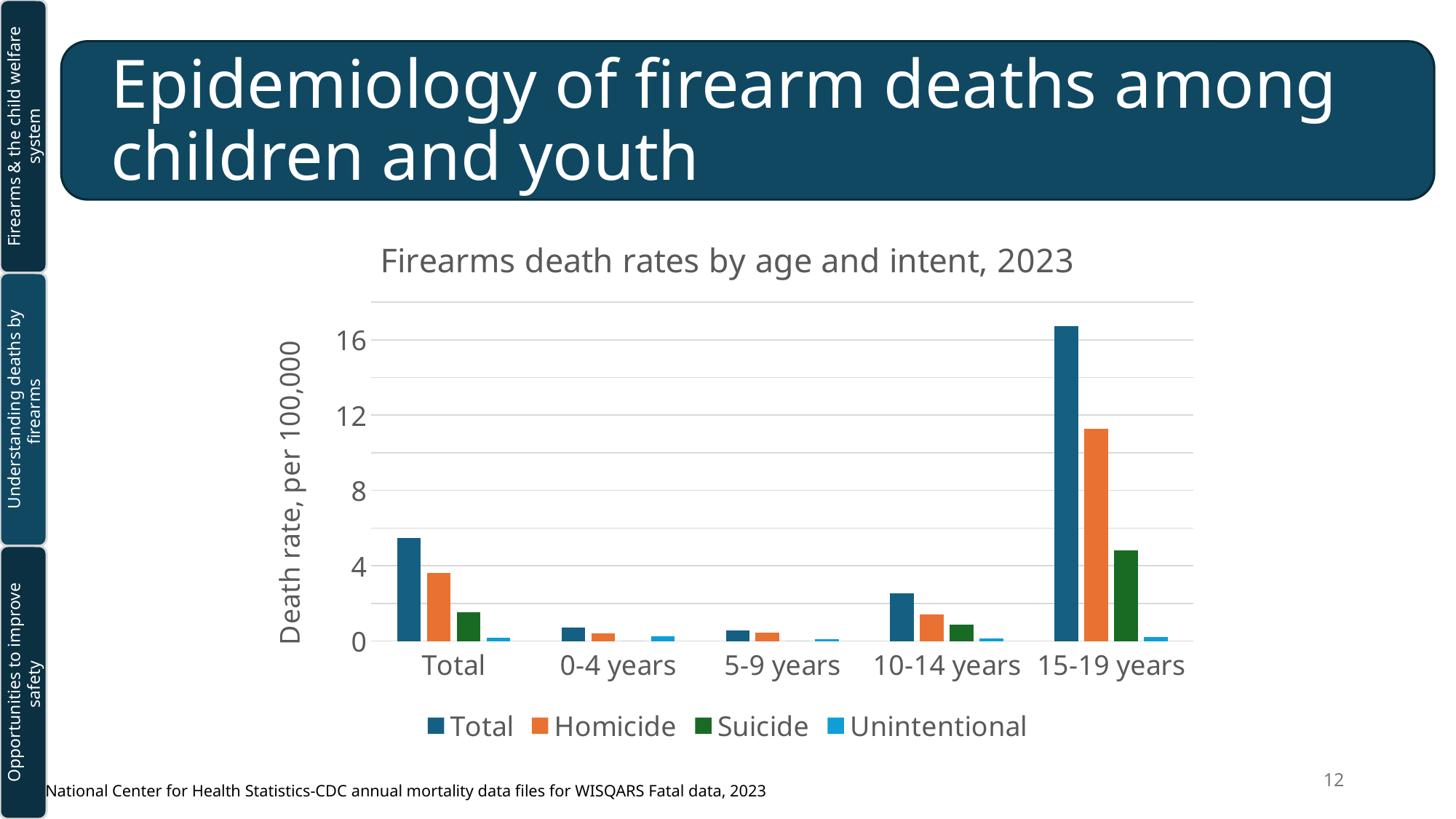
What is the title of the chart? Firearms death rates by age and intent, 2023 How many series does the legend list? 4 Which is larger for the 15-19 years group, the Homicide rate or the Suicide rate? Homicide Is the Homicide death rate for 15-19 years greater or less than 12? less Which series has the lowest death rate in the 15-19 years group? Unintentional Which age group has the highest Total firearm death rate? 15-19 years Is the Suicide death rate for 15-19 years greater or less than 4? greater What is the label of the y axis? Death rate, per 100,000 Is the Total death rate for the Total category greater or less than 4? greater How many age categories are shown on the x axis? 5 What type of chart is shown on the slide? bar chart